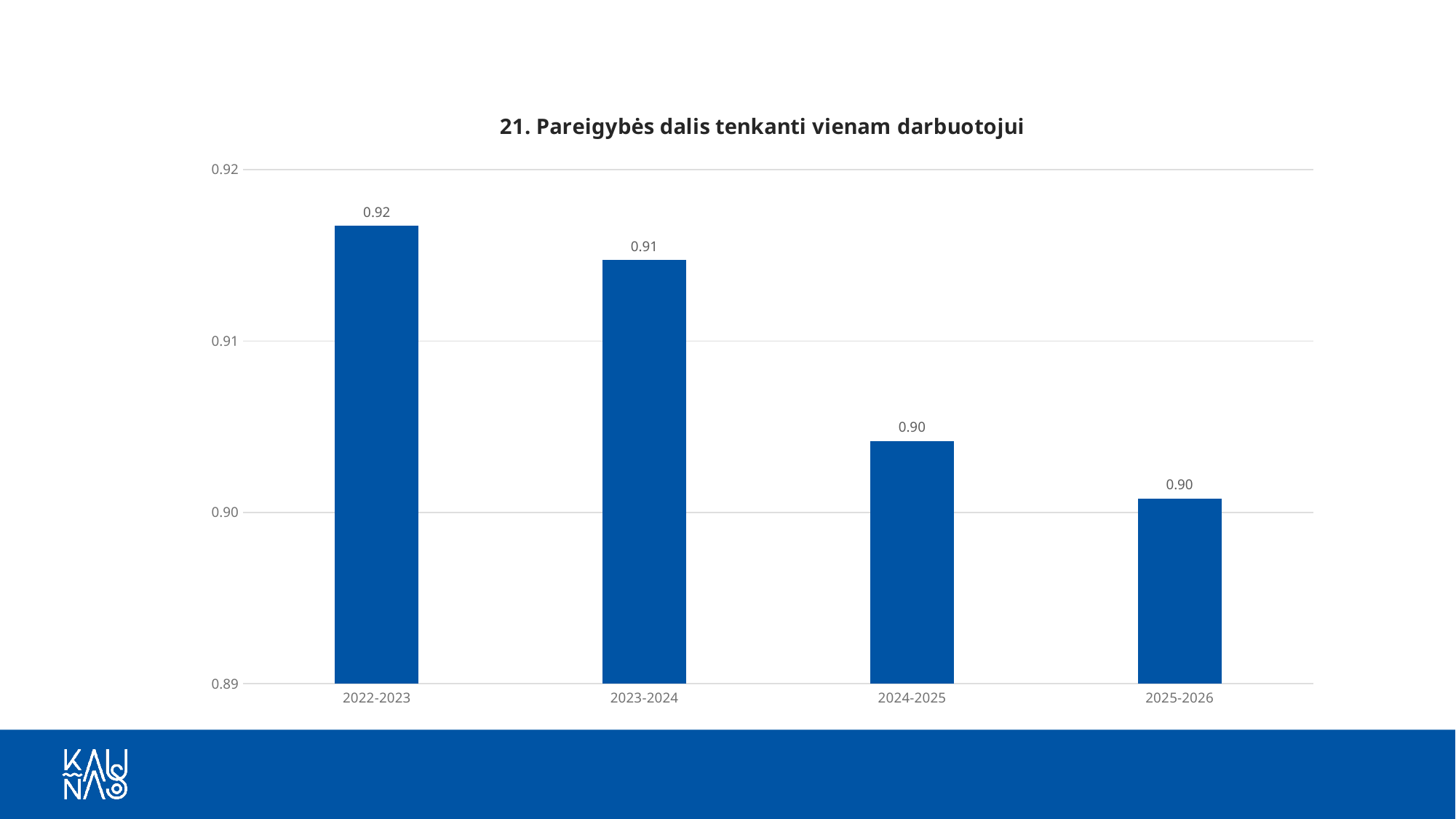
What is the value for 2022-2023? 0.92 What is the value for 2024-2025? 0.90 What is the value for 2023-2024? 0.91 Which period has the highest value? 2022-2023 Do the values rise or fall from 2022-2023 to 2025-2026? fall What kind of chart is shown on the slide? bar chart Which is larger, the value for 2022-2023 or the value for 2024-2025? 2022-2023 What is the value for 2025-2026? 0.90 How many periods are shown on the x axis? 4 What is the title of the chart? 21. Pareigybės dalis tenkanti vienam darbuotojui What is the difference between the values for 2022-2023 and 2023-2024? 0.01